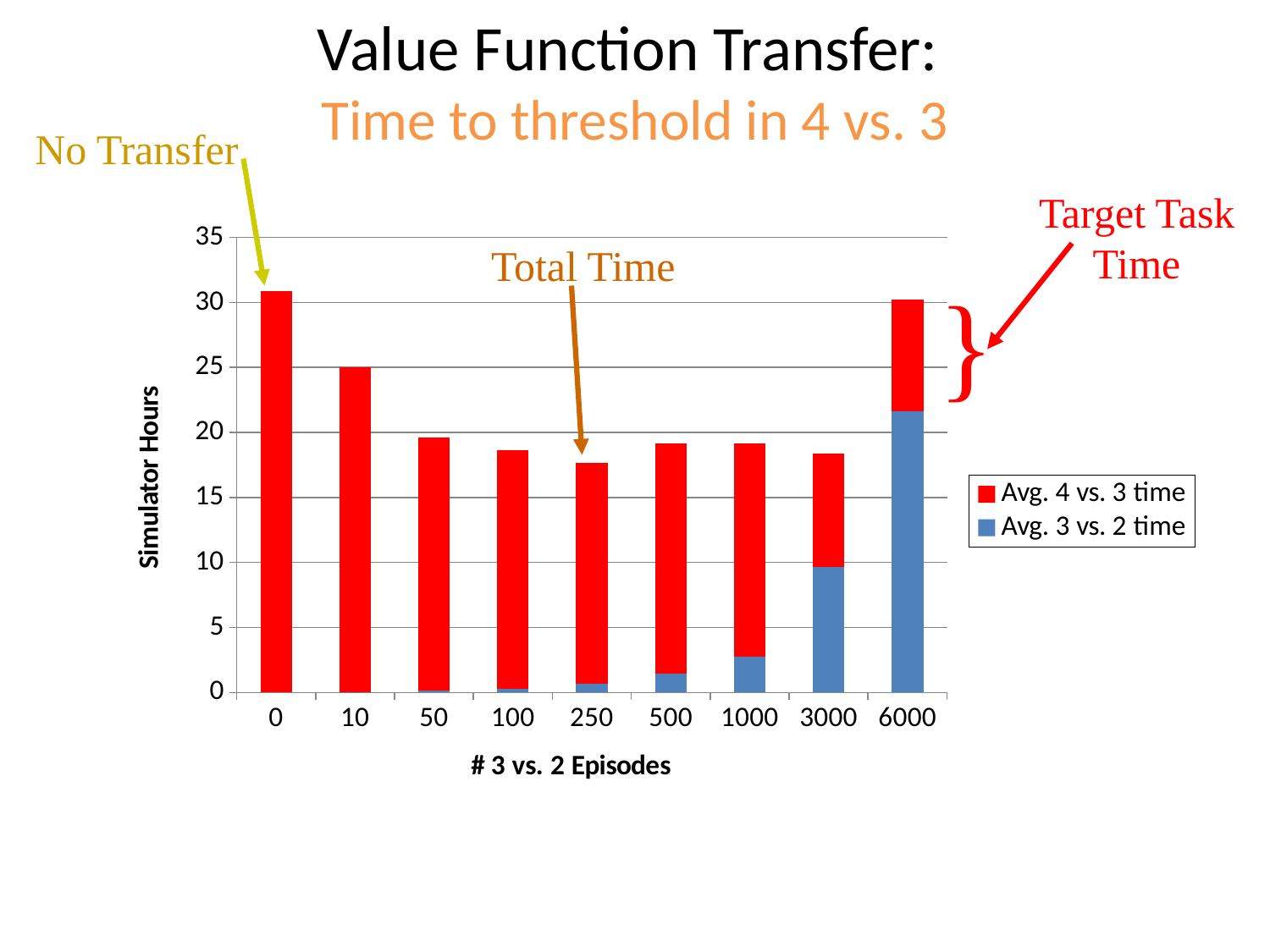
What is the label of the y axis? Simulator Hours Is the total bar height for 250 episodes greater or less than 20 simulator hours? less What is the label of the x axis? # 3 vs. 2 Episodes Is the Avg. 3 vs. 2 time for 6000 episodes greater or less than 20 simulator hours? greater Does the total bar height rise or fall from 0 episodes to 250 episodes? fall How many series does the legend list? 2 What kind of chart is shown on the slide? stacked bar chart Is the total bar height for 0 episodes greater or less than 30 simulator hours? greater How many categories are shown on the x axis? 9 Which category has the largest Avg. 3 vs. 2 time? 6000 Which has a taller total bar, 10 episodes or 50 episodes? 10